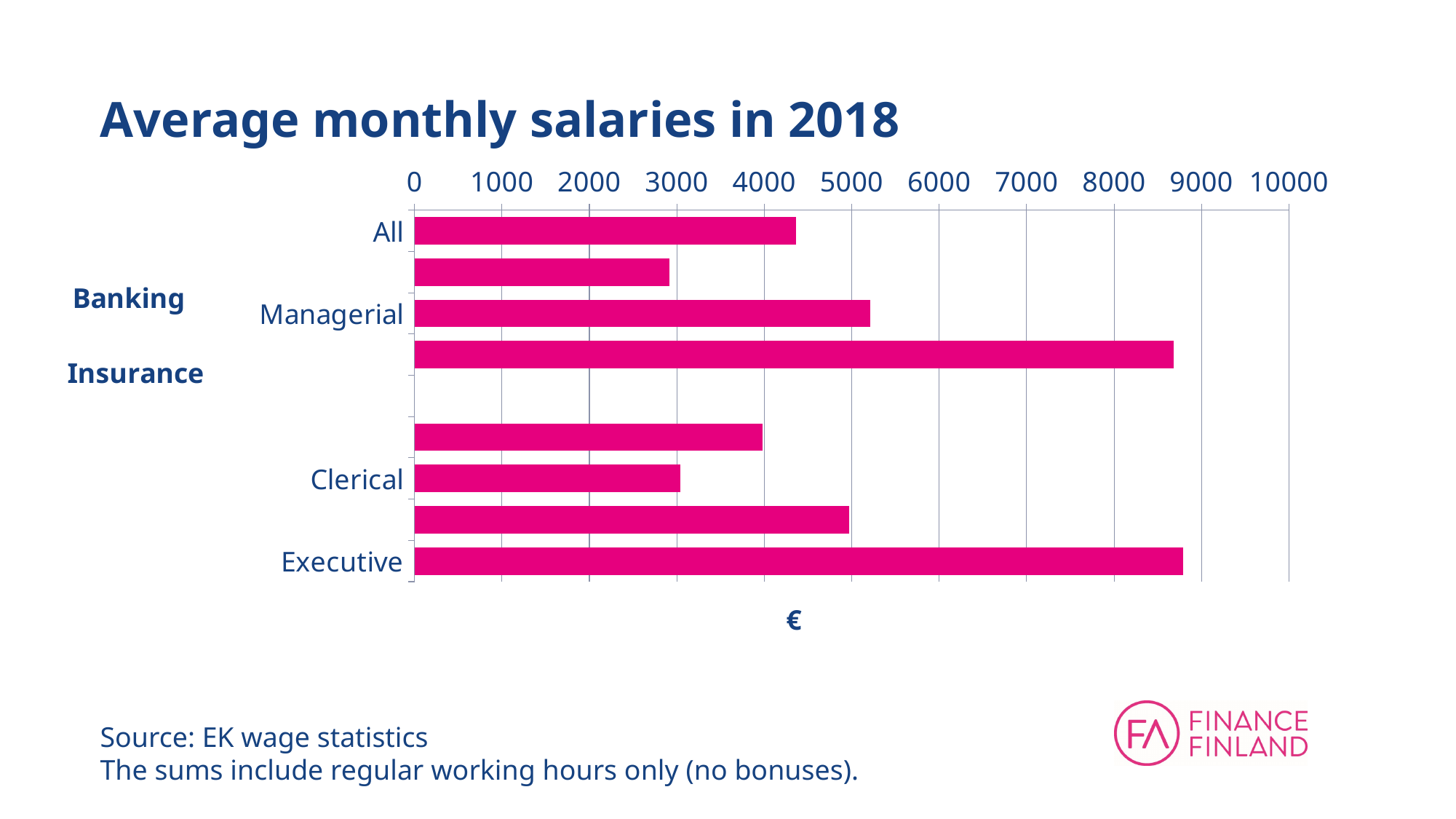
Is the value for the bar labeled Executive greater or less than 8000? greater How many bars are plotted in the chart? 8 Is the value for the bar labeled All greater or less than 4000? greater Which is larger, the bar labeled Executive or the bar labeled All? Executive What is the title of the chart? Average monthly salaries in 2018 Which is larger, the bar labeled Managerial or the bar labeled Clerical? Managerial What kind of chart is shown on the slide? bar chart Is the value for the bar labeled Clerical greater or less than 4000? less Which labeled category has the longest bar? Executive What unit is shown below the horizontal axis? €